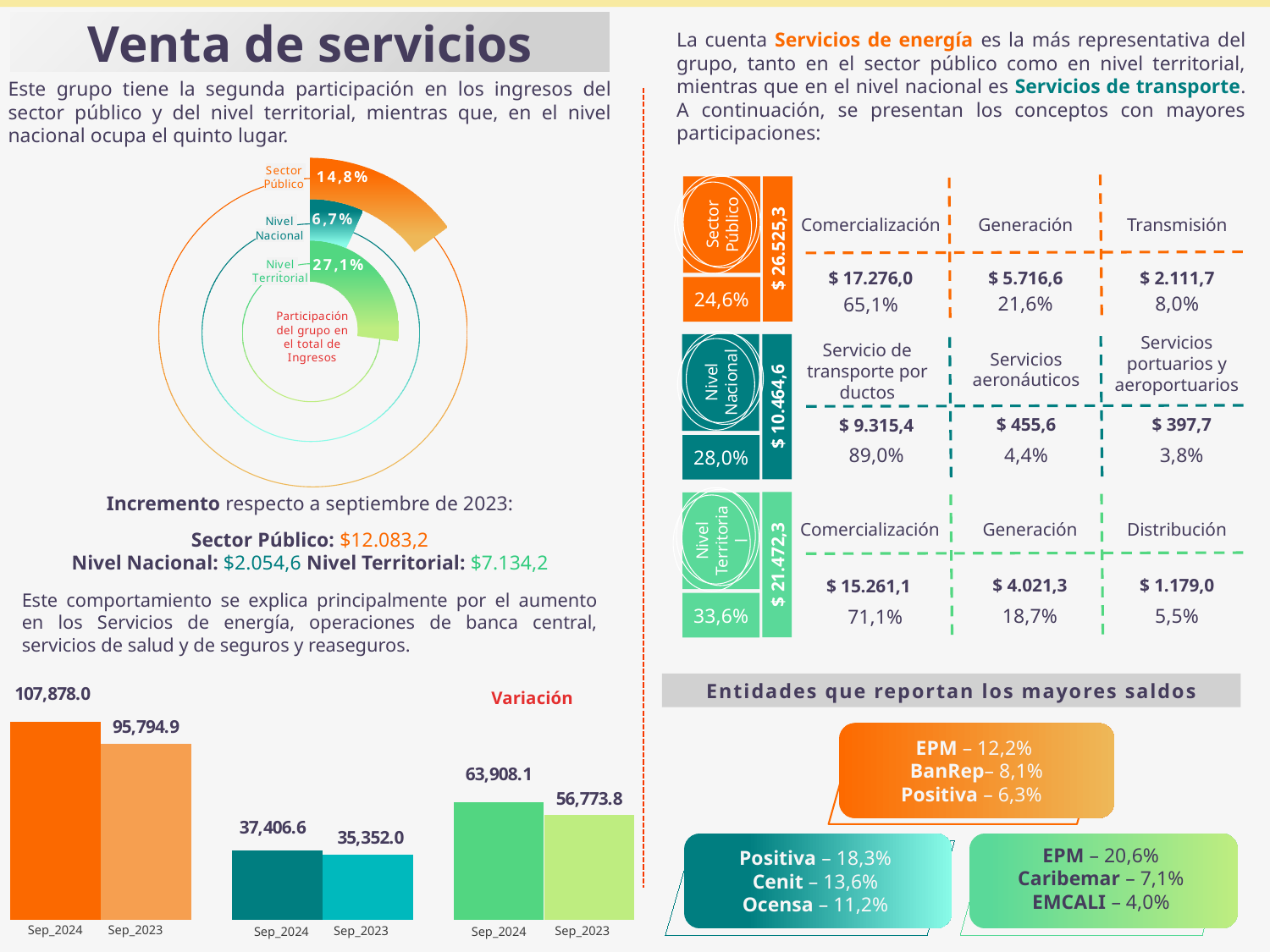
In the radial chart on the left (Participación del grupo en el total de Ingresos), what is the value for Sector Público? 14,8% In the radial chart on the left, how many levels are plotted? 3 In the radial chart on the left, what is the value for Nivel Nacional? 6,7% In the bar chart at the bottom left (Variación), what is the Sep_2024 value of the green bars? 63,908.1 In the radial chart on the left, what is the value for Nivel Territorial? 27,1% In the radial chart on the left, which level has the highest participation? Nivel Territorial What kind of chart is the Variación chart at the bottom left? Bar chart In the bar chart at the bottom left (Variación), what is the Sep_2023 value of the teal bars? 35,352.0 In the radial chart on the left, which level has the lowest participation? Nivel Nacional In the bar chart at the bottom left (Variación), what is the difference between the Sep_2024 and Sep_2023 values of the orange bars? 12,083.1 In the bar chart at the bottom left (Variación), what is the Sep_2024 value of the orange bars? 107,878.0 In the bar chart at the bottom left (Variación), which is larger for the green bars: Sep_2024 or Sep_2023? Sep_2024